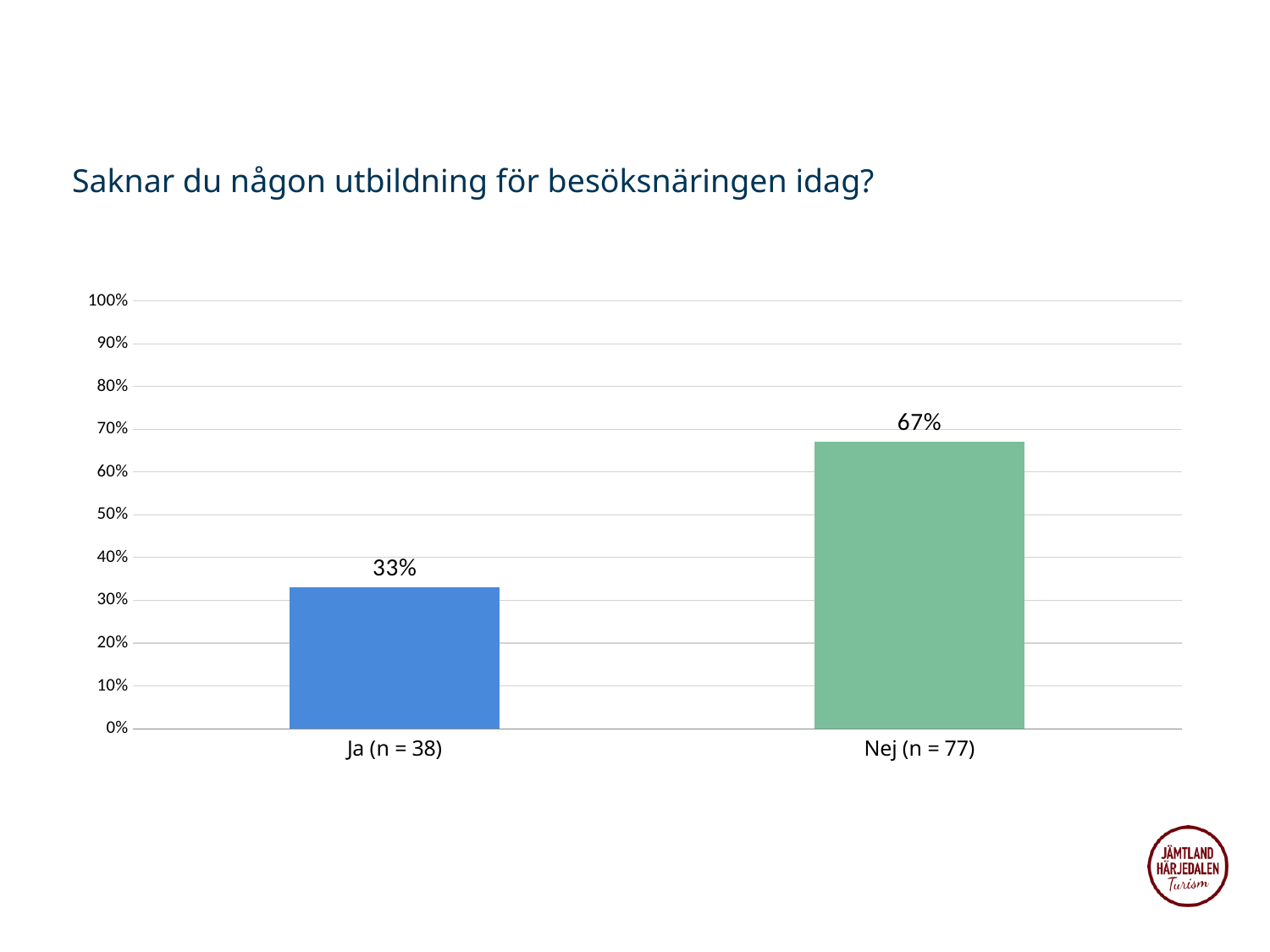
Is the value for Nej (n = 77) greater or less than 50%? greater Which is larger, the value for Ja (n = 38) or the value for Nej (n = 77)? Nej (n = 77) What is the title of the slide? Saknar du någon utbildning för besöksnäringen idag? What colour is the bar for Nej (n = 77)? Green Is the value for Ja (n = 38) greater or less than 40%? less What is the difference between the values for Nej (n = 77) and Ja (n = 38)? 34% What is the value for Nej (n = 77)? 67% Which category has the highest value? Nej (n = 77) Which category has the lowest value? Ja (n = 38) What kind of chart is shown on the slide? Bar chart How many categories are shown on the x axis? 2 What is the value for Ja (n = 38)? 33%